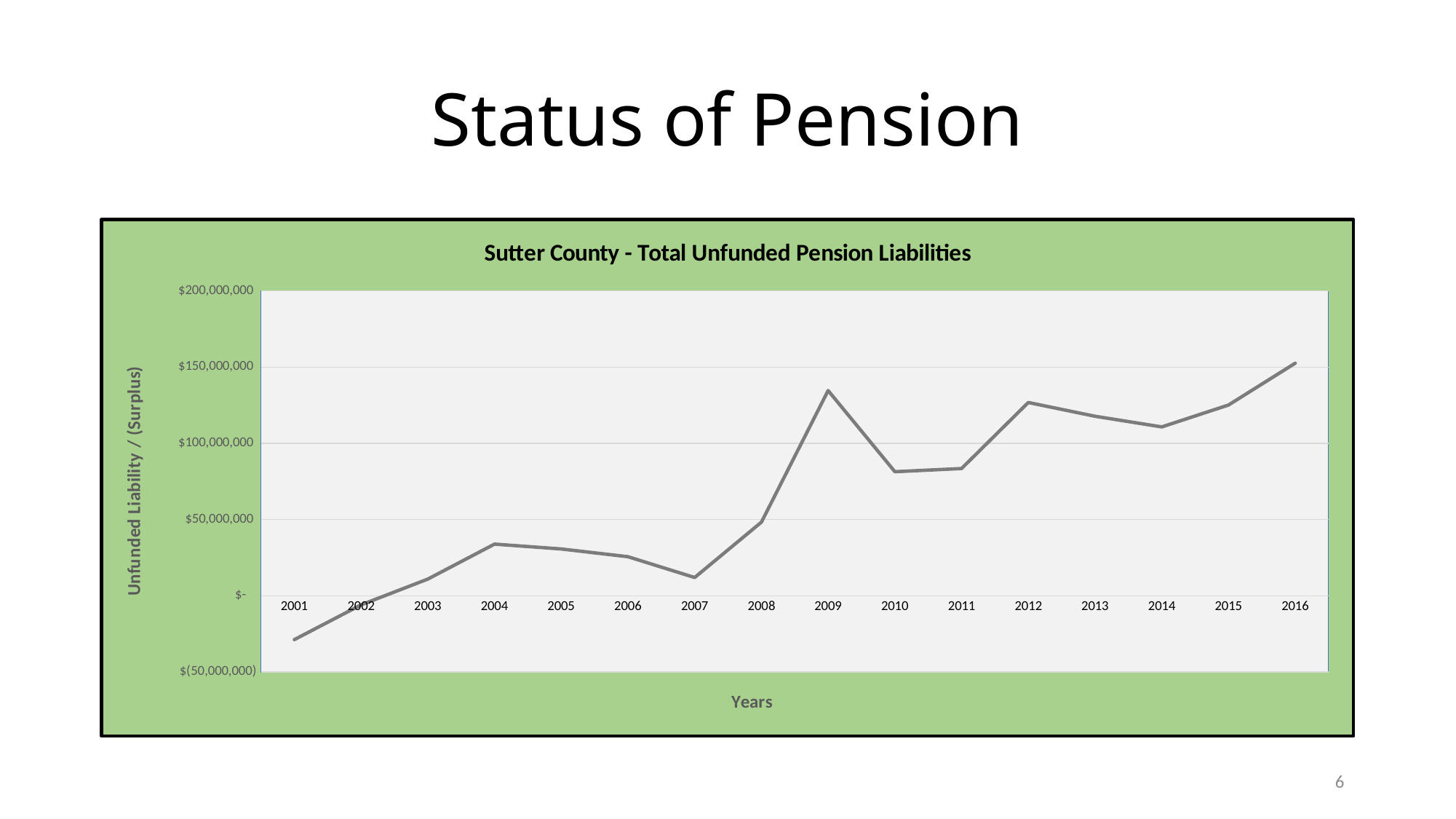
Is the value for 2009 greater or less than $100,000,000? greater Is the value for 2004 greater or less than $50,000,000? less What is the label on the vertical axis of the chart? Unfunded Liability / (Surplus) Which year has the larger value, 2009 or 2010? 2009 What kind of chart is shown on the slide? line chart Which year has the lowest value on the chart? 2001 What is the title of the chart? Sutter County - Total Unfunded Pension Liabilities Which year has the highest unfunded pension liability? 2016 How many years are plotted on the x axis of the chart? 16 Is the value for 2010 greater or less than $100,000,000? less Overall, do the values rise or fall from 2001 to 2016? rise